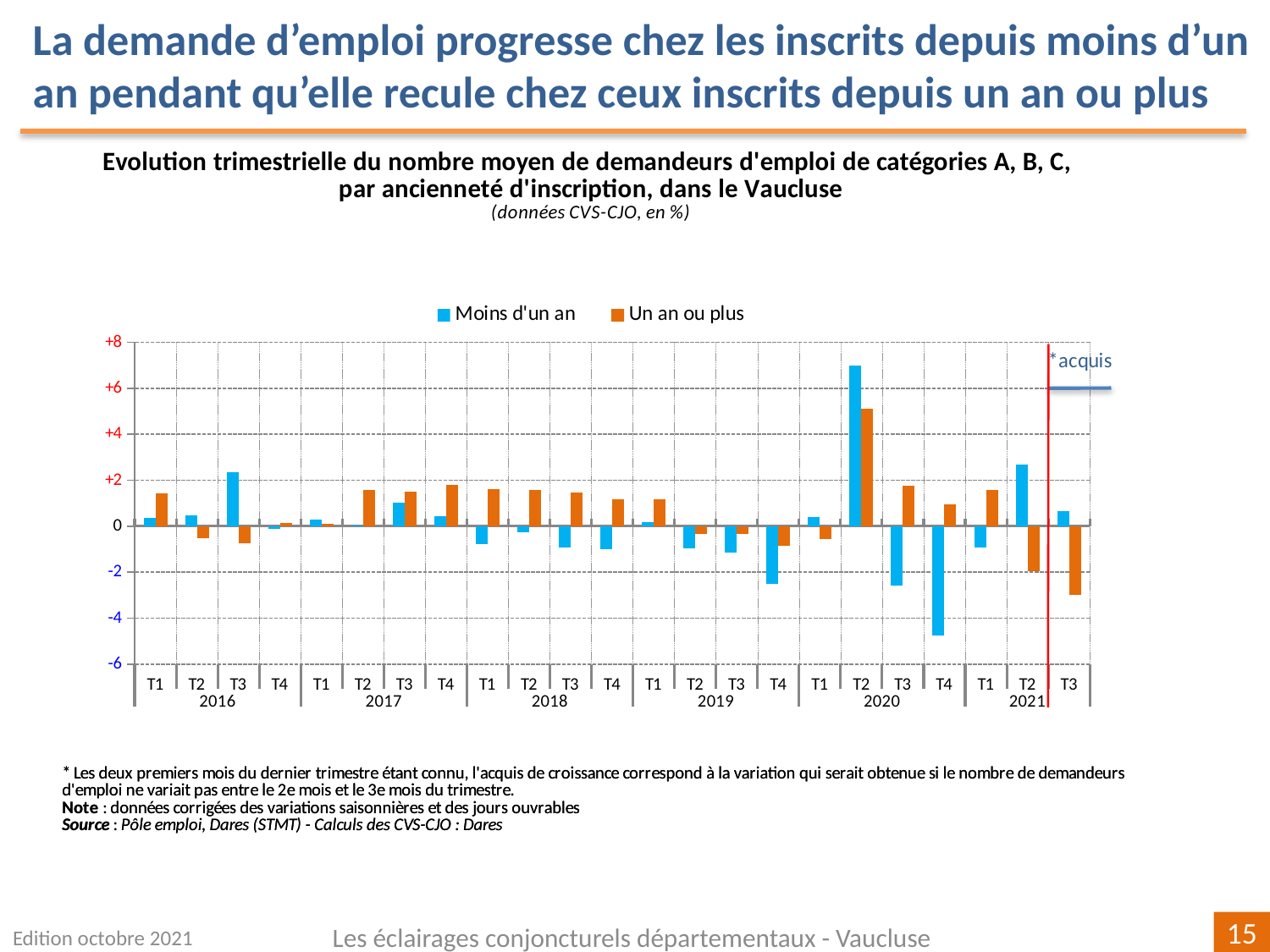
Which series is shown in orange in the legend? Un an ou plus In which quarter is the value for 'Moins d'un an' lowest? T4 2020 Is the value for 'Moins d'un an' in T4 2020 greater or less than -4? less How many series does the legend list? 2 In which quarter is the value for 'Un an ou plus' lowest? T3 2021 What kind of chart is shown on the slide? Bar chart In T3 2020, which series has the larger value, 'Moins d'un an' or 'Un an ou plus'? Un an ou plus How many quarters are plotted along the x axis? 23 In which quarter is the value for 'Moins d'un an' highest? T2 2020 Is the value for 'Un an ou plus' in T3 2021 greater or less than -2? less Is the value for 'Moins d'un an' in T2 2020 greater or less than +6? greater In T2 2020, which series has the larger value, 'Moins d'un an' or 'Un an ou plus'? Moins d'un an